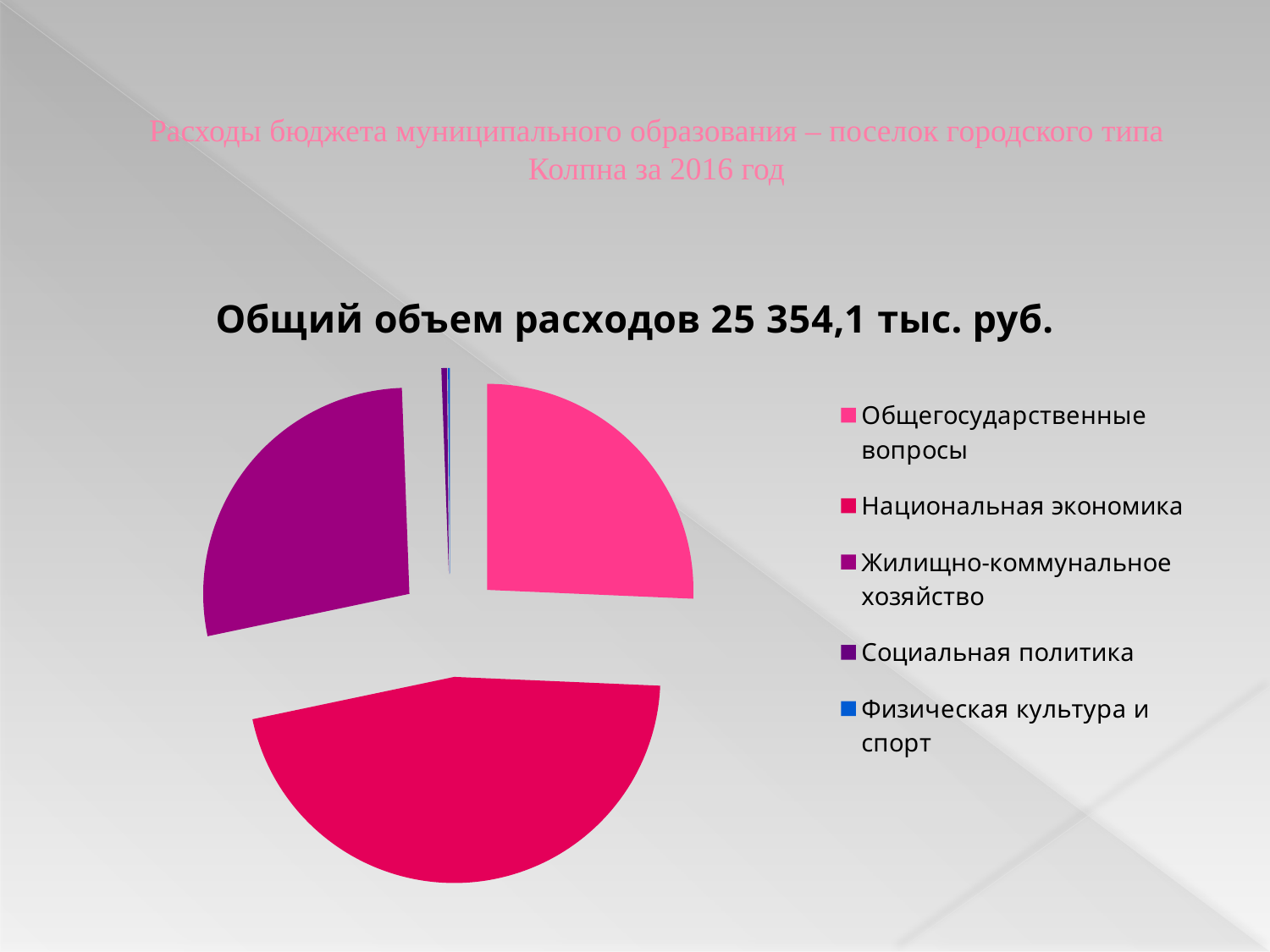
Which slice is larger: Национальная экономика or Общегосударственные вопросы? Национальная экономика Which slice is larger: Общегосударственные вопросы or Физическая культура и спорт? Общегосударственные вопросы What total volume of expenditures is stated in the chart title? 25 354,1 тыс. руб. Which category is shown in blue in the legend? Физическая культура и спорт Which category has the largest slice of the pie? Национальная экономика How many categories does the pie chart's legend list? 5 Which slice is larger: Жилищно-коммунальное хозяйство or Социальная политика? Жилищно-коммунальное хозяйство What is the title of the chart? Общий объем расходов 25 354,1 тыс. руб. What kind of chart is shown on the slide? pie chart